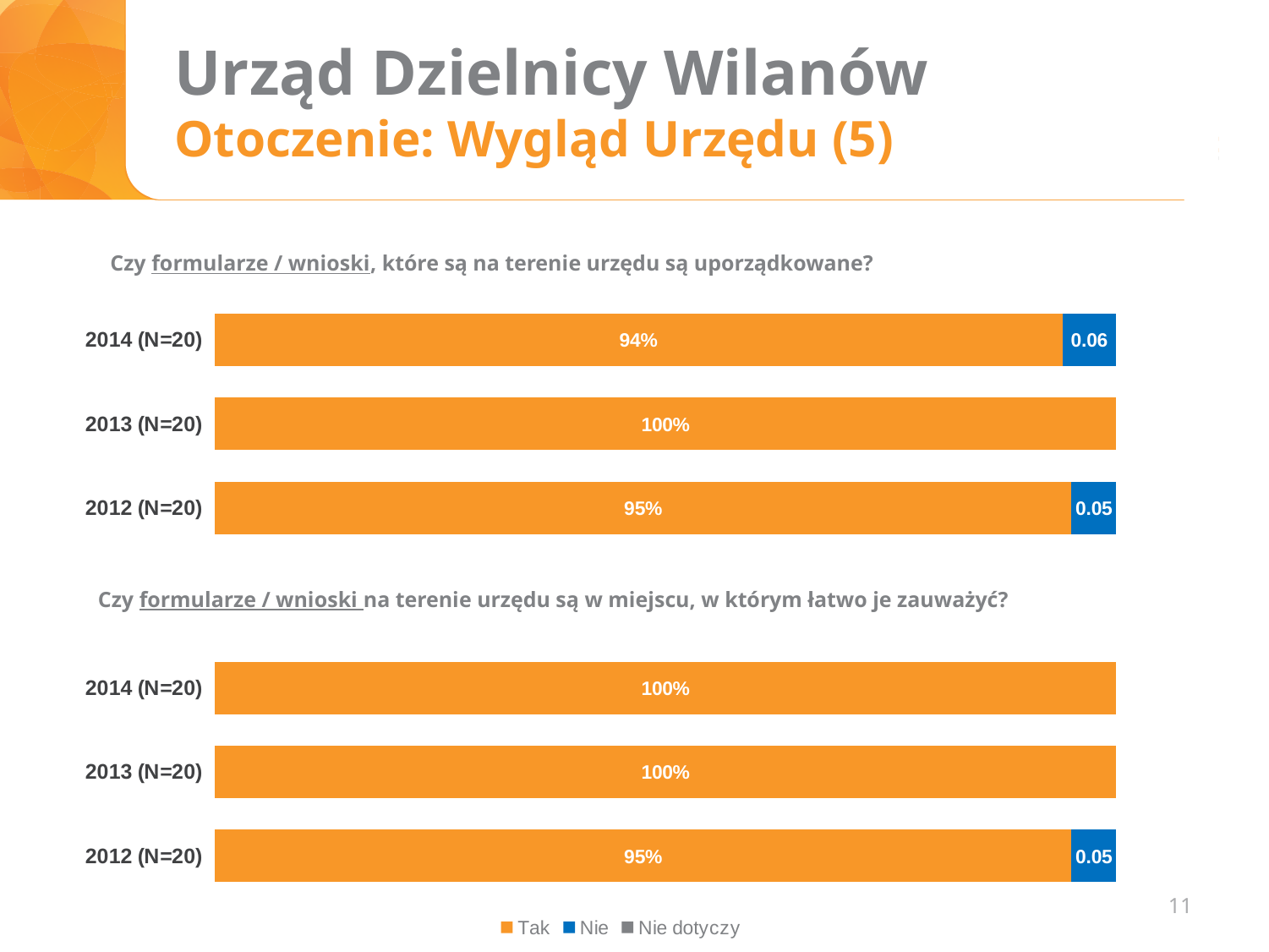
In the bottom chart, what is the "Tak" value for 2014 (N=20)? 100% In the top chart, which year has the lowest "Tak" value? 2014 (N=20) In the bottom chart ("Czy formularze / wnioski na terenie urzędu są w miejscu, w którym łatwo je zauważyć?"), what is the "Tak" value for 2012 (N=20)? 95% In the top chart ("Czy formularze / wnioski, które są na terenie urzędu są uporządkowane?"), what is the "Tak" value for 2014 (N=20)? 94% In the top chart, what is the "Nie" value for 2012 (N=20)? 0.05 In the top chart, which year has the highest "Tak" value? 2013 (N=20) How many series does the legend at the bottom of the slide list? 3 In the top chart, what is the "Nie" value for 2014 (N=20)? 0.06 In the top chart, what is the difference between the "Tak" values for 2013 (N=20) and 2014 (N=20)? 6% In the bottom chart, which year has the lowest "Tak" value? 2012 (N=20) What kind of chart is the bottom chart? Bar chart In the top chart, what is the "Tak" value for 2013 (N=20)? 100%